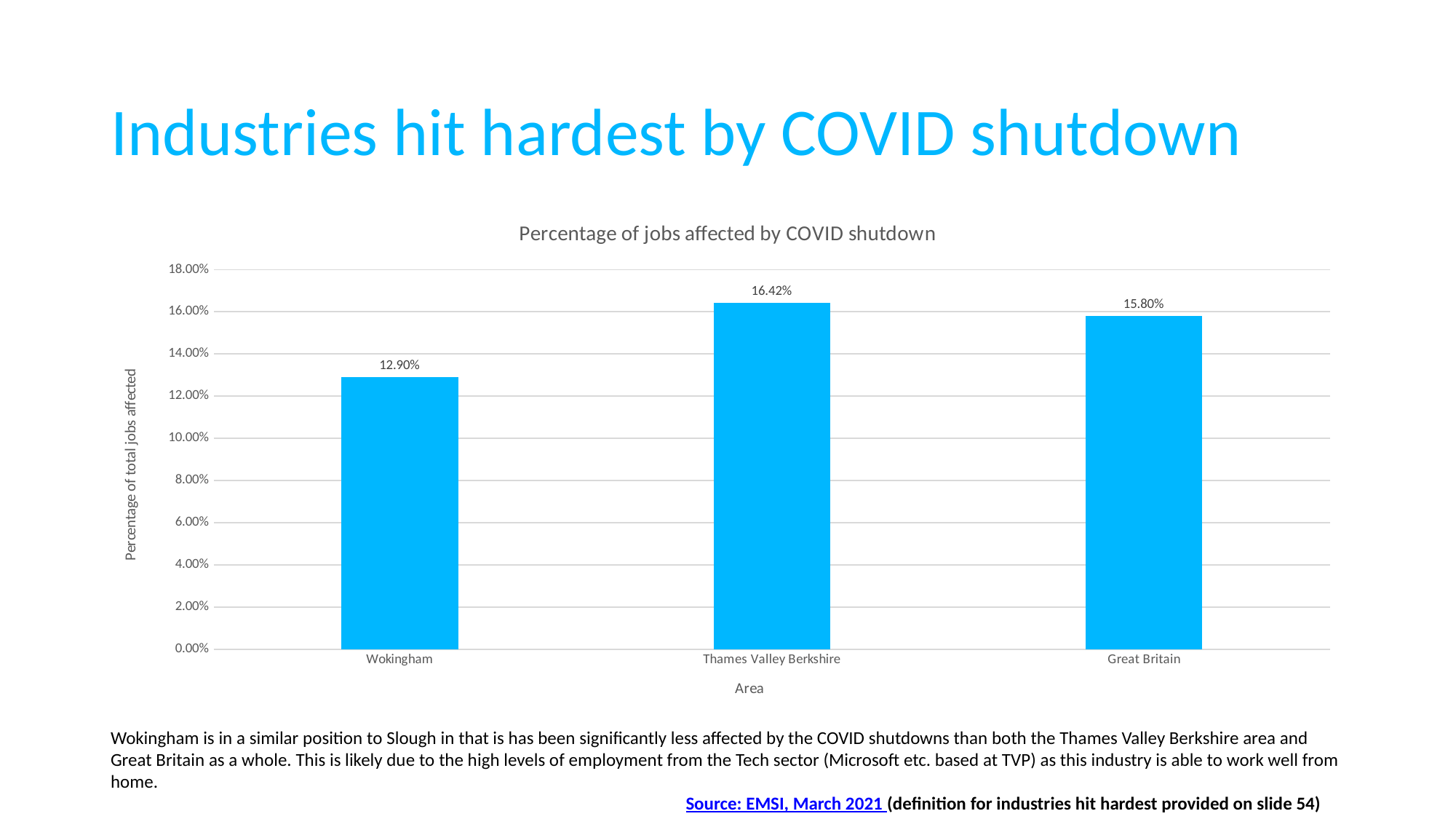
What is the difference between the percentage of jobs affected in Thames Valley Berkshire and in Wokingham? 3.52% Which has a higher percentage of jobs affected by COVID shutdown, Great Britain or Wokingham? Great Britain What kind of chart is shown on the slide? Bar chart How many areas are shown in the chart? 3 Which area has the highest percentage of jobs affected by COVID shutdown? Thames Valley Berkshire What is the percentage of jobs affected by COVID shutdown for Thames Valley Berkshire? 16.42% Is the value for Wokingham greater or less than 14.00%? less What is the percentage of jobs affected by COVID shutdown for Wokingham? 12.90% What is the percentage of jobs affected by COVID shutdown for Great Britain? 15.80% What is the title of the chart? Percentage of jobs affected by COVID shutdown Which area has the lowest percentage of jobs affected by COVID shutdown? Wokingham What is the difference between the percentage of jobs affected in Great Britain and in Wokingham? 2.90%